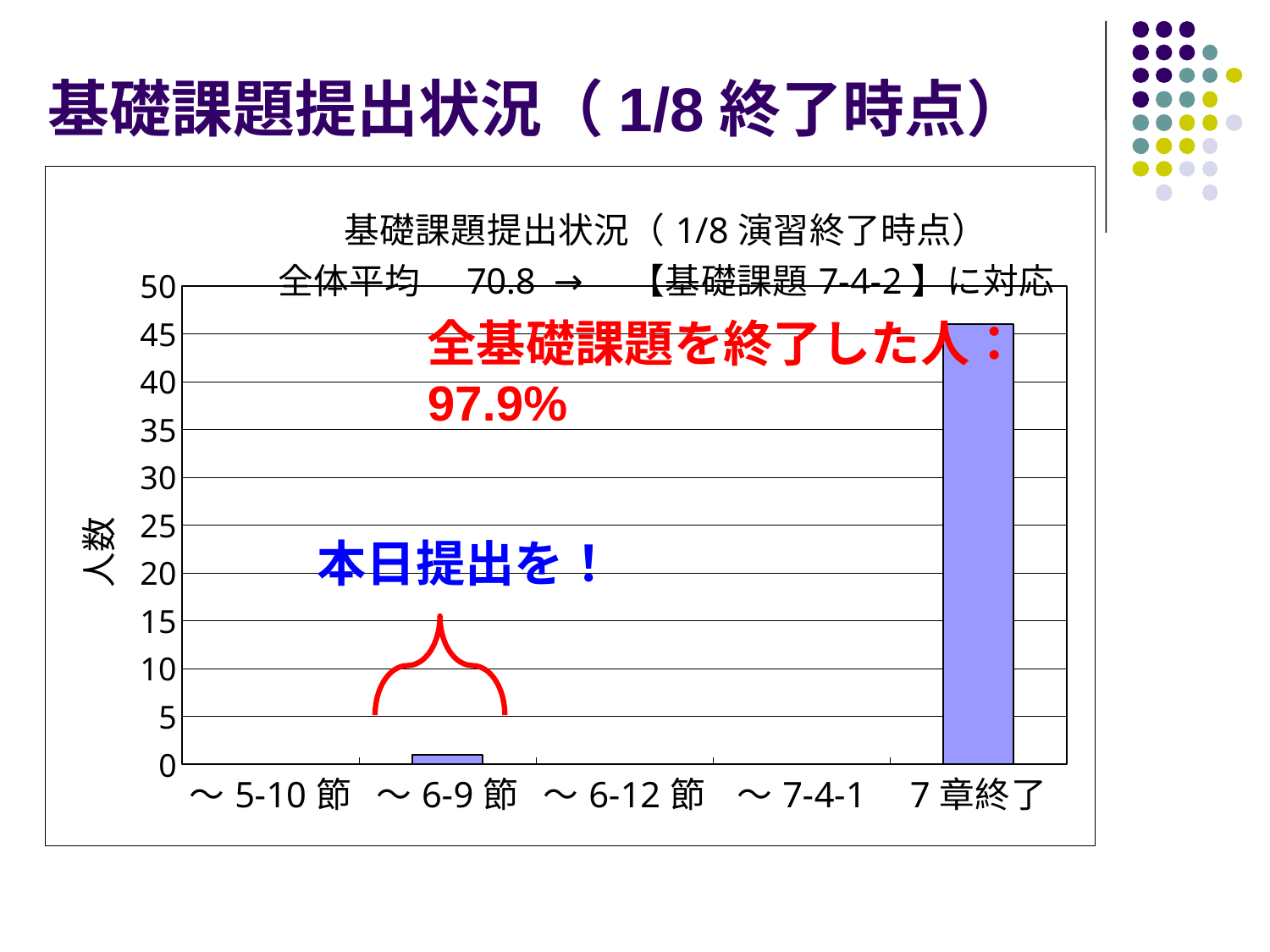
Is the value for ～6-9節 greater or less than 5? less Is the value for 7章終了 greater or less than 50? less What is the title of the chart? 基礎課題提出状況（1/8演習終了時点） 全体平均 70.8 → 【基礎課題7-4-2】に対応 Which category has the highest bar in the chart? 7章終了 How many categories are shown on the x axis of the chart? 5 Is the value for ～6-9節 greater or less than 10? less What kind of chart is shown on the slide? bar chart Which is larger, the value for 7章終了 or the value for ～6-9節? 7章終了 What percentage of people completed all basic assignments, according to the red annotation on the chart? 97.9%